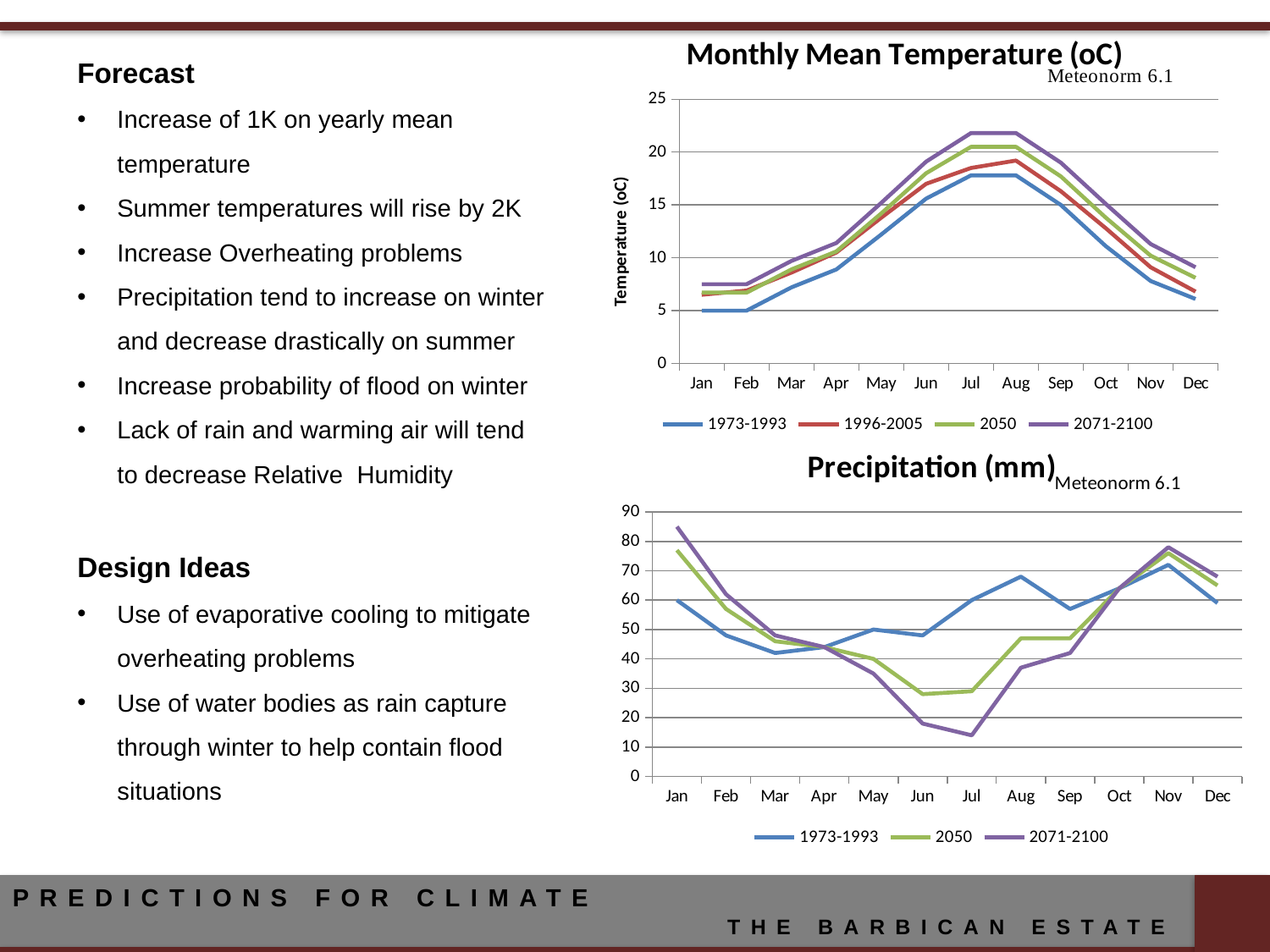
In the Monthly Mean Temperature chart, is the value for 2071-2100 in Jul greater or less than 20? greater In the Precipitation (mm) chart, which month has the lowest value for the 2071-2100 series? Jul In the Monthly Mean Temperature chart, which series has the highest temperature in Jul? 2071-2100 In the Precipitation (mm) chart, is the value for 2071-2100 in Jan greater or less than 80? greater In the Precipitation (mm) chart, which is larger in Jul: the 1973-1993 value or the 2071-2100 value? 1973-1993 In the Precipitation (mm) chart, is the value for 2071-2100 in Jul greater or less than 20? less How many months are plotted along the x axis of the Monthly Mean Temperature chart? 12 What kind of chart is the Monthly Mean Temperature chart? line chart How many series does the legend of the Precipitation (mm) chart list? 3 How many series does the legend of the Monthly Mean Temperature chart list? 4 In the Monthly Mean Temperature chart, does the 1973-1993 series rise or fall from Jan to Jul? rise